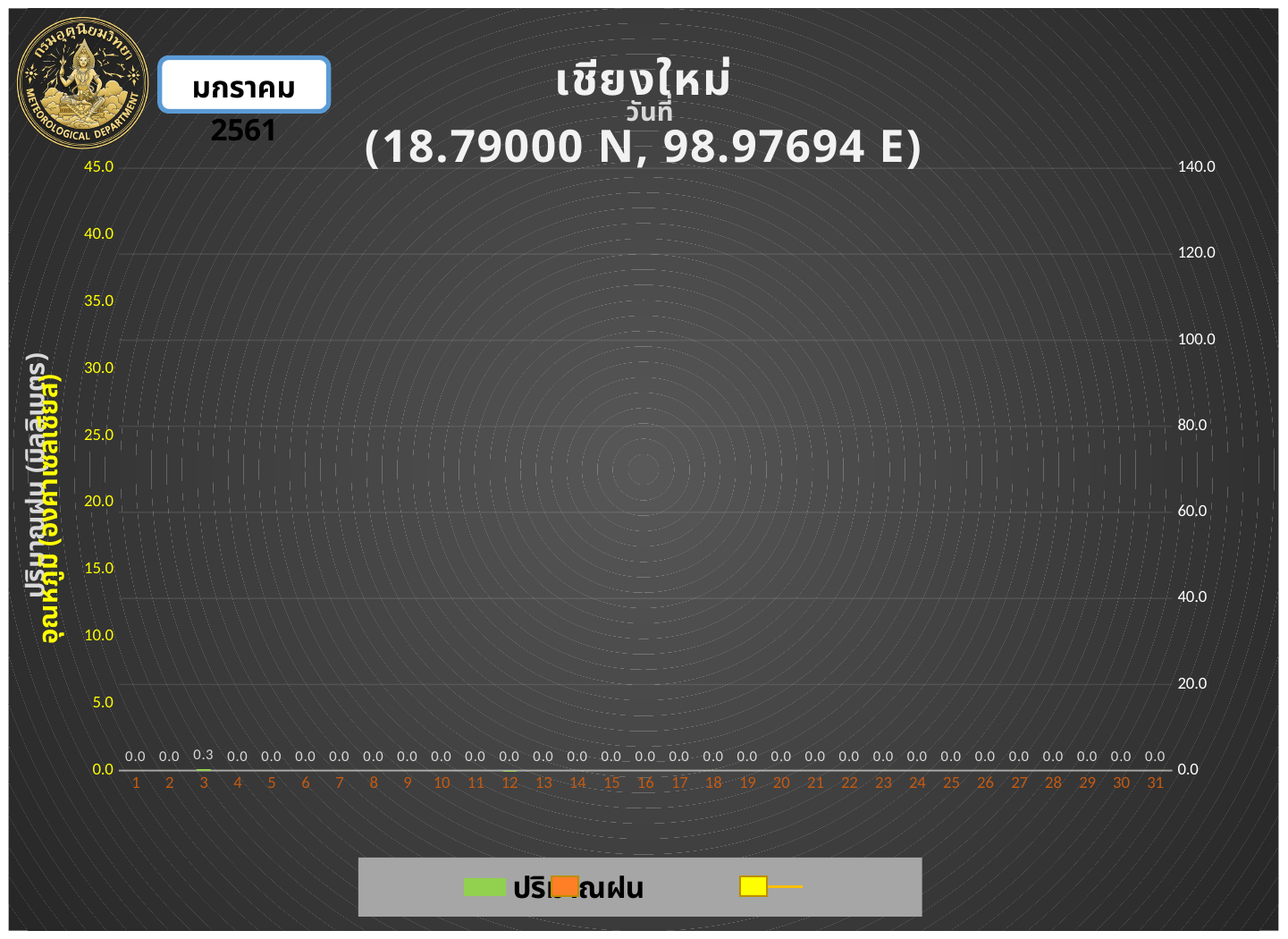
What kind of chart is shown on the slide? bar chart What is the highest tick value on the right vertical axis? 140.0 What is the highest tick value on the left vertical axis? 45.0 What is the rainfall value shown for day 1? 0.0 How many days are shown along the x axis? 31 Which is larger, the rainfall value for day 3 or for day 10? day 3 What is the rainfall value shown for day 20? 0.0 Is the rainfall value for day 3 greater or less than 5.0 on the left axis? less Which day has the highest rainfall value? 3 What is the rainfall value shown for day 3? 0.3 What is the difference between the rainfall values for day 3 and day 5? 0.3